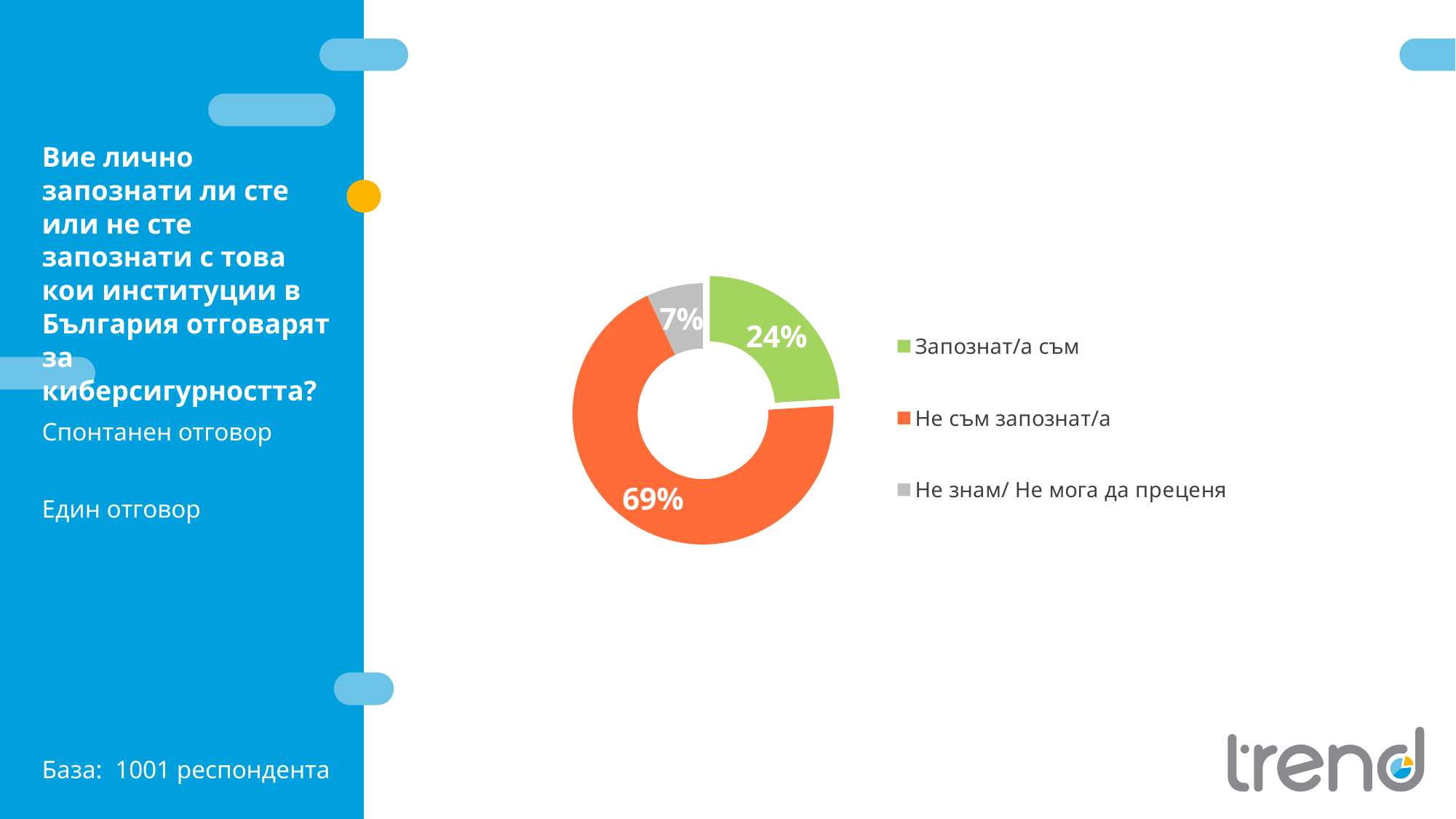
What is the combined share of "Запознат/а съм" and "Не знам/ Не мога да преценя"? 31% How many entries does the legend list? 3 What percentage of respondents answered "Не съм запознат/а"? 69% What kind of chart is shown on the slide? Doughnut chart Which is larger: the share for "Запознат/а съм" or the share for "Не знам/ Не мога да преценя"? Запознат/а съм How many answer categories are shown in the chart? 3 What is the difference in percentage points between "Не съм запознат/а" and "Запознат/а съм"? 45 What percentage of respondents answered "Запознат/а съм"? 24% What percentage of respondents answered "Не знам/ Не мога да преценя"? 7% Which answer category has the smallest share of the chart? Не знам/ Не мога да преценя What colour represents "Не съм запознат/а" in the chart? Orange Which answer category has the largest share of the chart? Не съм запознат/а